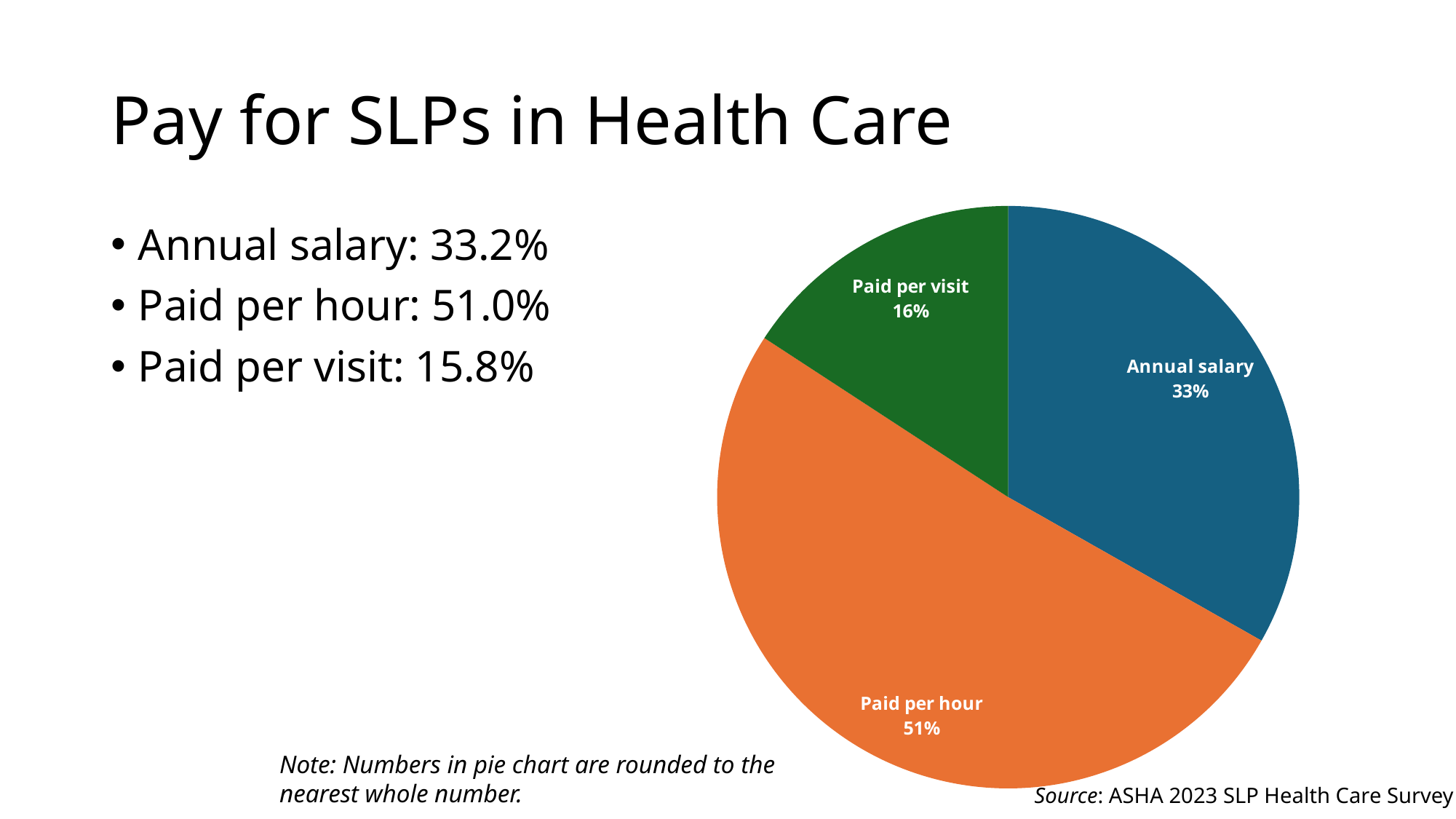
Which slice is larger in the pie chart, Annual salary or Paid per visit? Annual salary What percentage does the pie chart show for Paid per hour? 51% What kind of chart is shown on the slide? pie chart What colour is the Paid per hour slice in the pie chart? orange Which pay type has the smallest slice of the pie chart? Paid per visit What percentage does the pie chart show for Paid per visit? 16% How many slices does the pie chart have? 3 What is the difference in percentage points between the Annual salary slice and the Paid per visit slice in the pie chart? 17 What colour is the Paid per visit slice in the pie chart? green What is the difference in percentage points between the Paid per hour slice and the Annual salary slice in the pie chart? 18 What percentage does the pie chart show for Annual salary? 33% Which pay type has the largest slice of the pie chart? Paid per hour